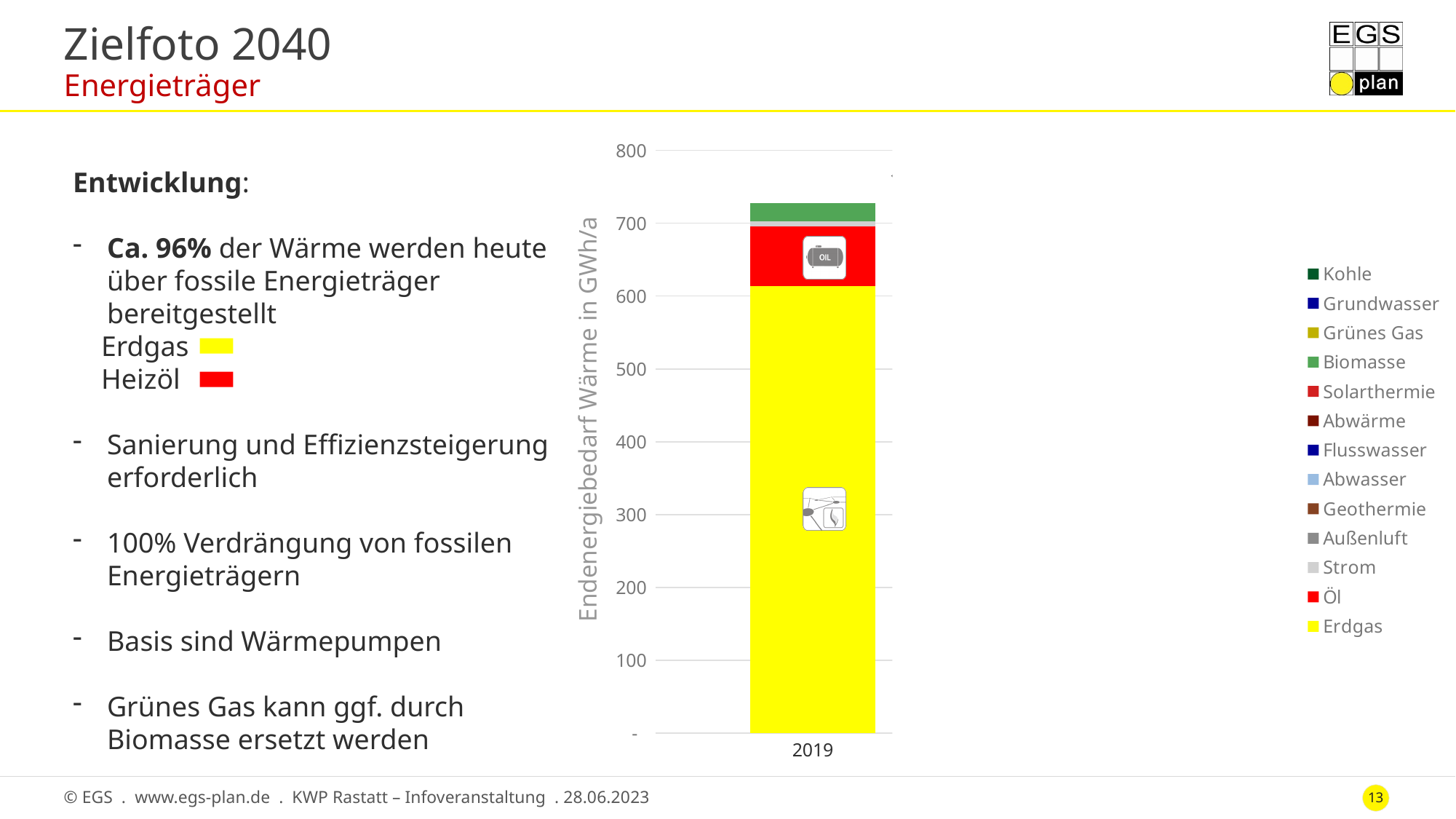
What is the label of the chart's y axis? Endenergiebedarf Wärme in GWh/a How many categories (years) are shown on the x axis of the chart? 1 Which year is shown on the x axis of the chart? 2019 Which energy source makes up the largest segment of the 2019 bar? Erdgas What colour represents Erdgas in the chart's legend? Yellow How many series does the chart's legend list? 13 Which segment of the 2019 bar is larger, Öl or Biomasse? Öl Is the total height of the 2019 stacked bar greater or less than 700? greater Is the total height of the 2019 stacked bar greater or less than 800? less Is the Erdgas segment of the 2019 bar greater or less than 500 GWh/a? greater What kind of chart is shown on the slide? Stacked bar chart